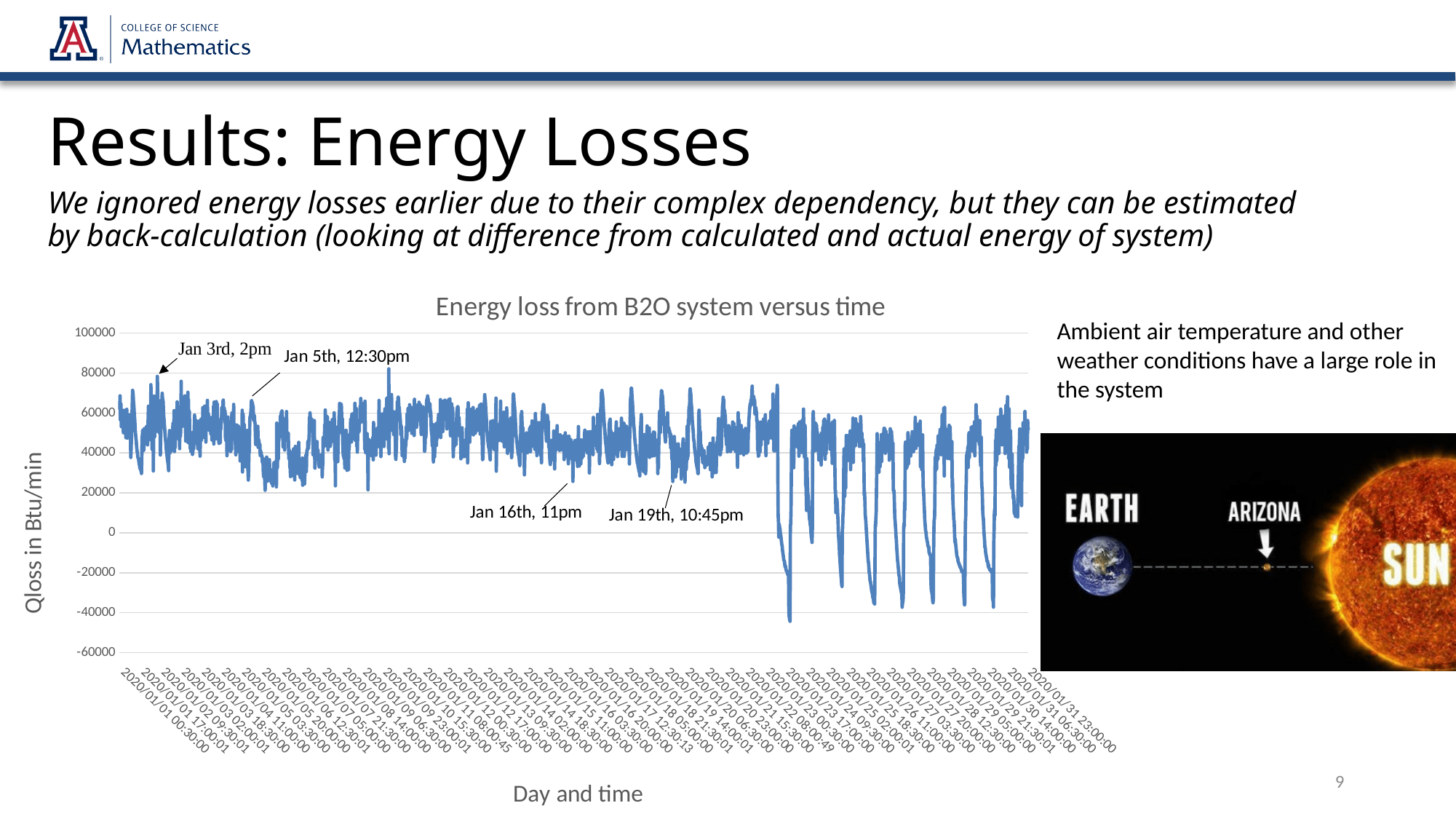
Is the value annotated as Jan 5th, 12:30pm greater or less than 40000? greater What kind of chart is shown on the slide? line chart Is the value annotated as Jan 16th, 11pm greater or less than 40000? less What is the label on the vertical axis of the chart? Qloss in Btu/min Does the plotted energy loss drop below 0 at any point during the month? yes What is the lowest tick value shown on the vertical axis? -60000 How many data series are plotted in the chart? 1 Is the value annotated as Jan 19th, 10:45pm greater or less than 40000? less What is the highest tick value shown on the vertical axis? 100000 What is the title of the chart? Energy loss from B2O system versus time Which annotated point has the larger value, Jan 3rd, 2pm or Jan 16th, 11pm? Jan 3rd, 2pm